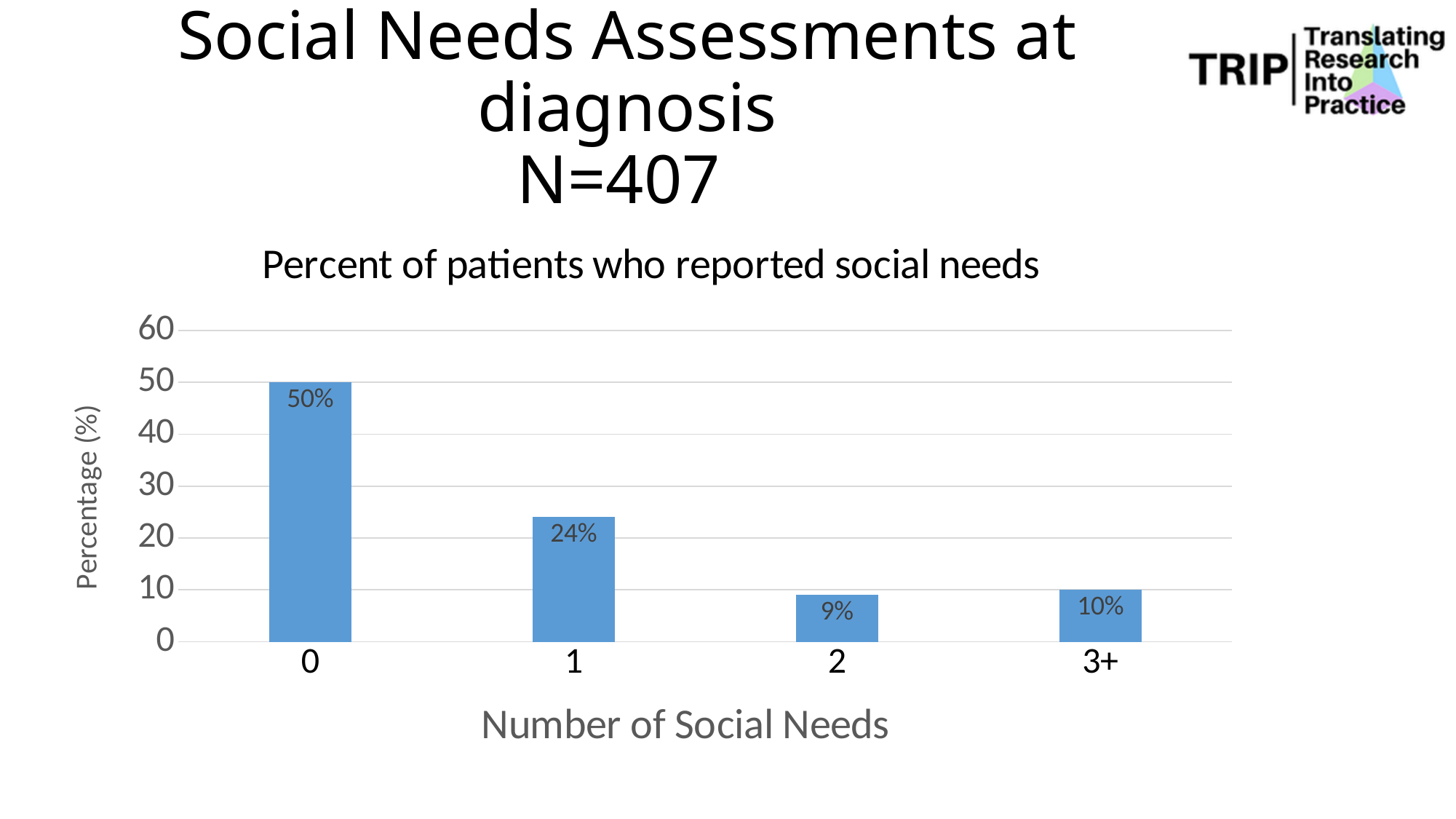
Which number of social needs category has the highest percentage of patients? 0 What is the difference in percentage points between the 0 and 1 social needs categories? 26 What kind of chart is shown on the slide? Bar chart What is the title of the chart? Percent of patients who reported social needs Which category has a larger percentage, 2 social needs or 3+ social needs? 3+ How many categories are shown on the x axis of the chart? 4 What percentage of patients reported 2 social needs? 9% What is the label of the x axis of the chart? Number of Social Needs What percentage of patients reported 1 social need? 24% What percentage of patients reported 3+ social needs? 10% What percentage of patients reported 0 social needs? 50% Which number of social needs category has the lowest percentage of patients? 2